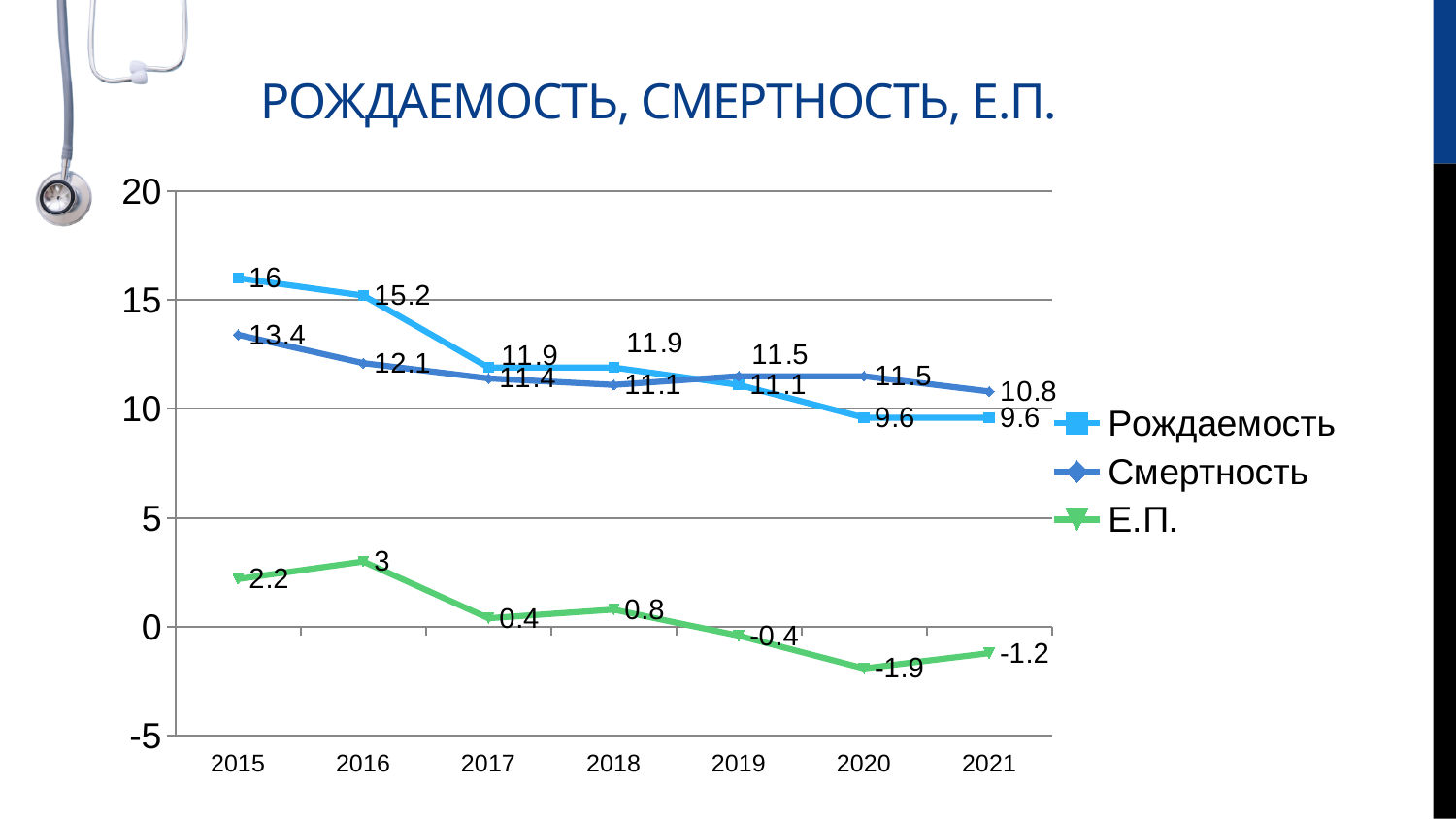
What is the title of the chart? РОЖДАЕМОСТЬ, СМЕРТНОСТЬ, Е.П. What type of chart is shown on the slide? line chart Which is larger in 2019, Рождаемость or Смертность? Смертность What is the value of Смертность in 2021? 10.8 What is the value of Рождаемость in 2015? 16 What is the value of Е.П. in 2020? -1.9 What is the difference between Рождаемость in 2015 and in 2016? 0.8 Does Рождаемость rise or fall from 2015 to 2021? fall How many series does the legend list? 3 How many years are shown on the x axis? 7 In which year is Рождаемость highest? 2015 In which year is Е.П. lowest? 2020